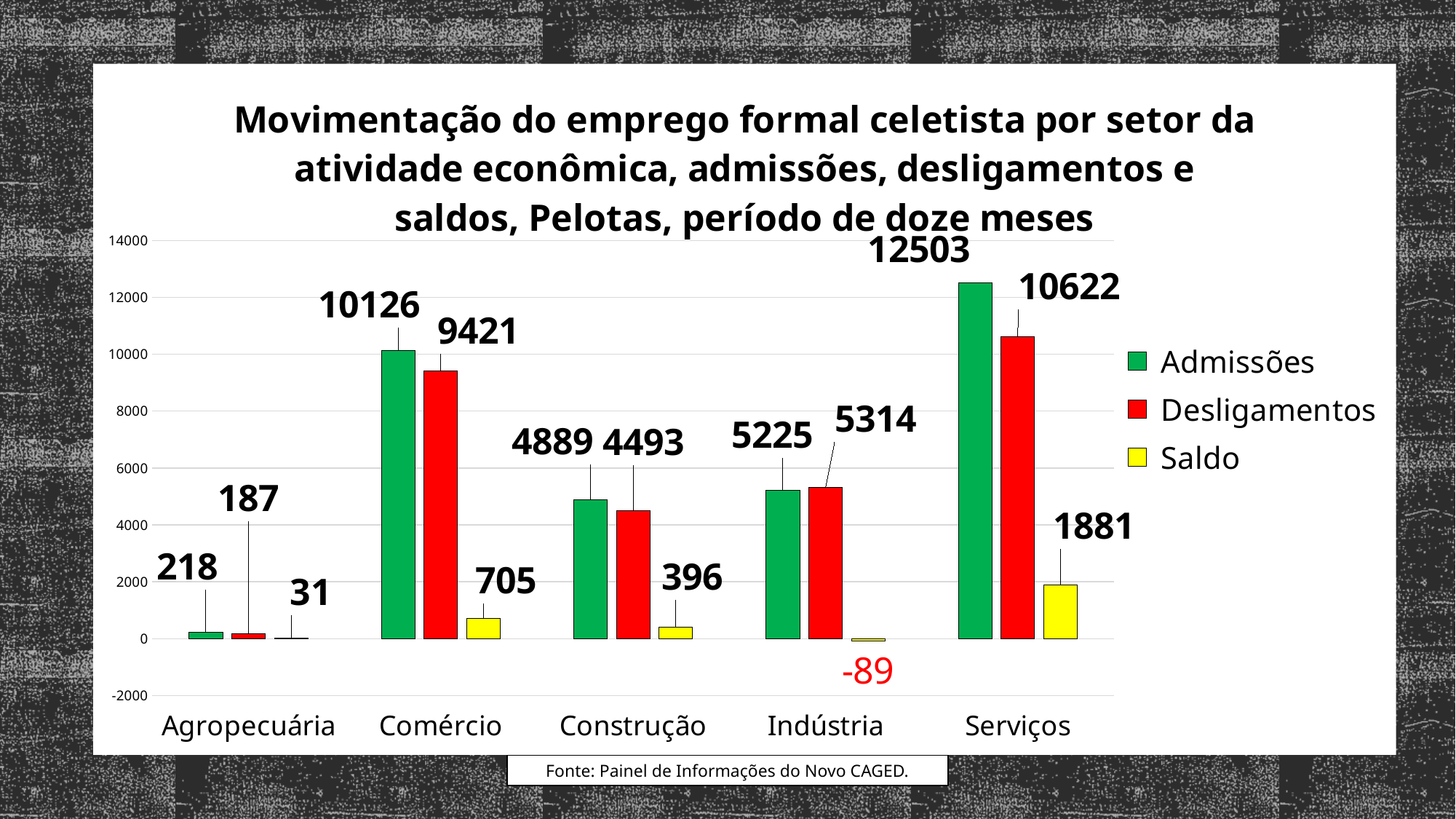
What is the difference between Admissões and Desligamentos for Comércio? 705 How many sectors are shown on the x axis? 5 Which is larger for Indústria, Admissões or Desligamentos? Desligamentos What is the Saldo value for Indústria? -89 Which sector has the lowest Saldo value? Indústria Which sector has the highest Admissões value? Serviços What is the value of Admissões for Comércio? 10126 What is the value of Desligamentos for Serviços? 10622 What colour represents the Saldo series in the legend? Yellow What is the Saldo value for Agropecuária? 31 How many series does the legend list? 3 What kind of chart is shown on the slide? Bar chart